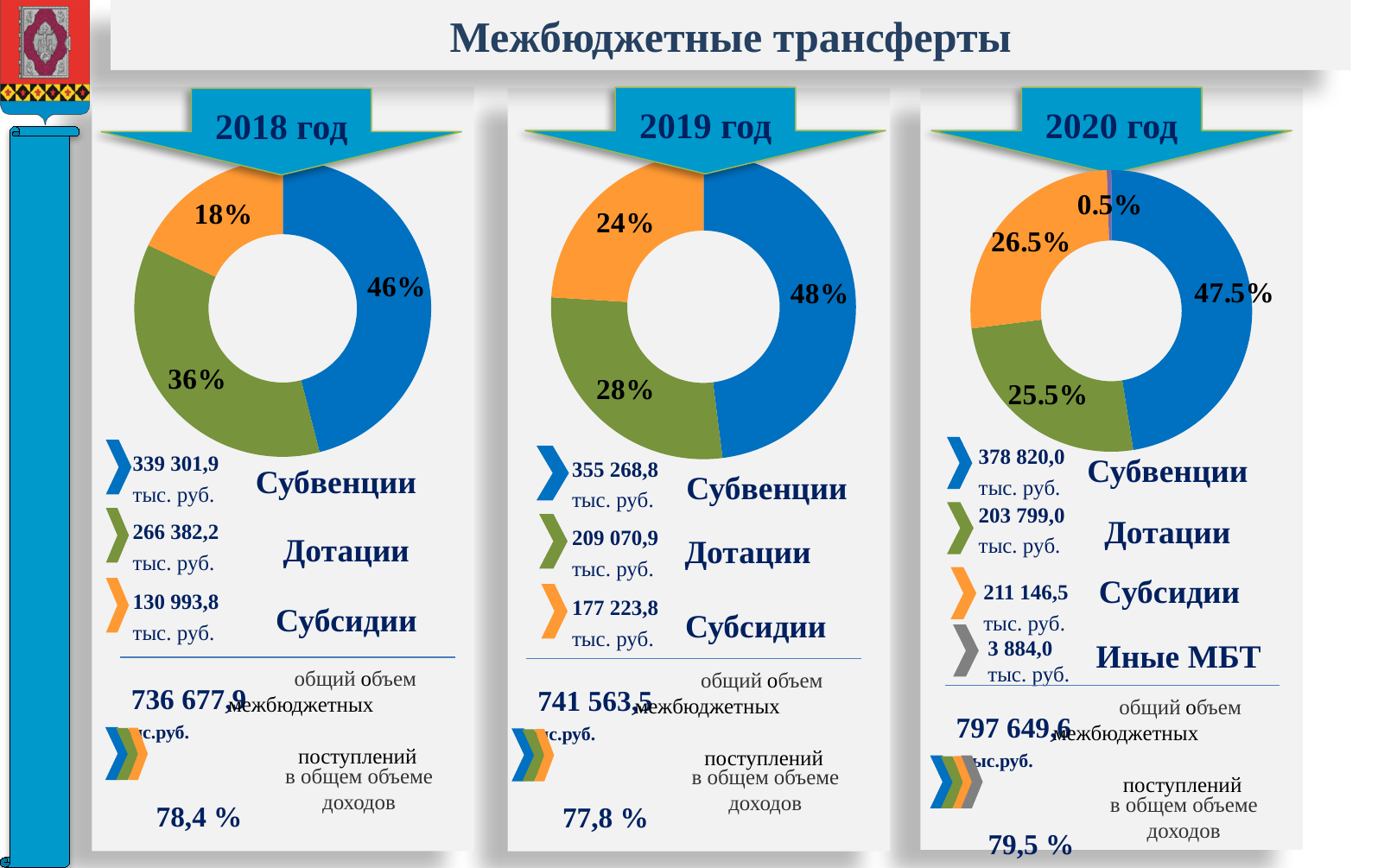
In the 2020 год chart, which is larger, Дотации or Субсидии? Субсидии In the 2020 год chart, what share of the pie is Иные МБТ? 0.5% How many slices does the 2020 год chart have? 4 In the 2020 год chart, what colour is the Субвенции slice? Blue In the 2018 год chart, what share of the pie is Субвенции? 46% In the 2020 год chart, which category has the smallest slice? Иные МБТ In the 2018 год chart, which category has the largest slice? Субвенции In the 2019 год chart, what share of the pie is Субсидии? 24% What kind of chart is used for the 2018 год data? Pie (donut) chart How many slices does the 2019 год chart have? 3 In the 2018 год chart, what is the value shown for Дотации? 36% In the 2019 год chart, what is the difference in percentage points between Субвенции and Дотации? 20